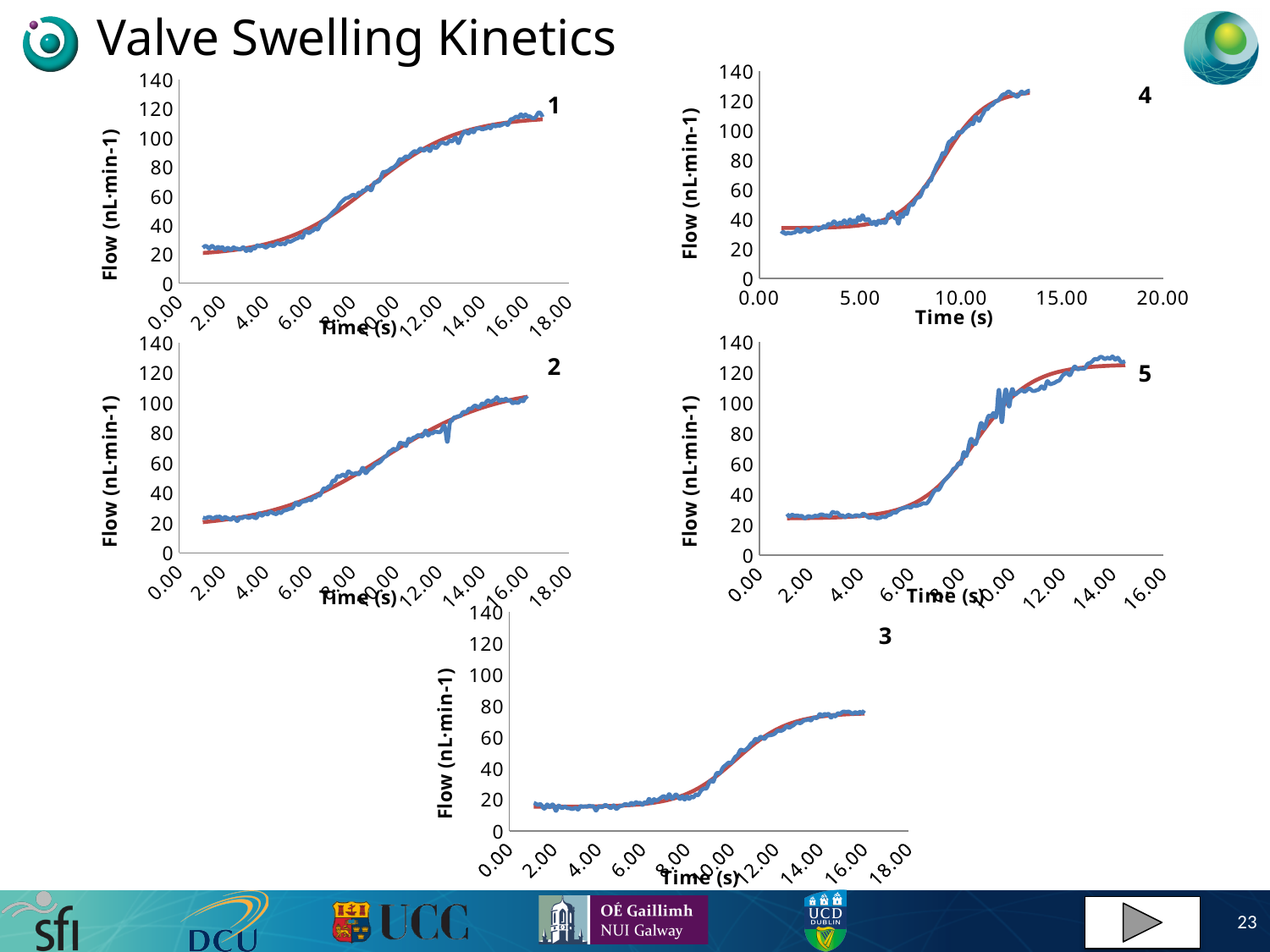
In the chart labelled 4, is the flow value at the end of the curve greater or less than 120? greater What kind of chart is the chart labelled 1? line chart In the chart labelled 1, is the flow value at the end of the curve greater or less than 100? greater Which chart reaches the lowest final flow value, the chart labelled 3 or the chart labelled 4? 3 In the chart labelled 3, is the flow value at the start of the curve greater or less than 20? less What is the largest value shown on the x axis of the chart labelled 4? 20.00 How many charts are shown on the slide? 5 In the chart labelled 3, does the flow rise or fall as time increases? rise Which of the five charts reaches the lowest final flow value? 3 What is the y-axis title on the chart labelled 2? Flow (nL·min-1)